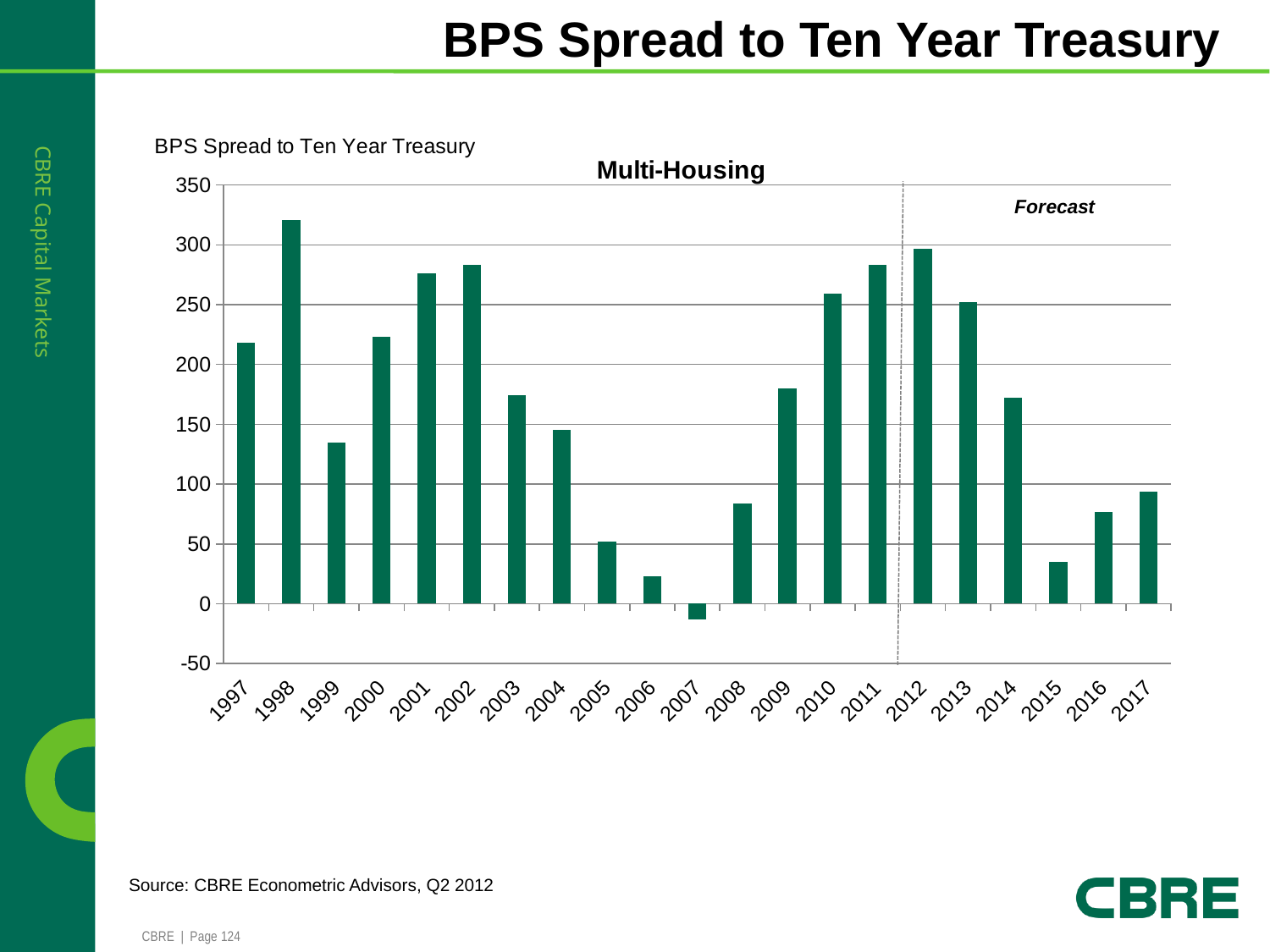
What label appears to the right of the dashed vertical line in the chart? Forecast Do the values rise or fall from 2004 to 2007? fall Which year has the lowest BPS spread in the Multi-Housing chart? 2007 Is the value for 1997 greater or less than 200? greater Which is larger, the value for 2009 or the value for 2010? 2010 What kind of chart is shown on the slide? bar chart Is the value for 2016 greater or less than 100? less Which is larger, the value for 1998 or the value for 2012? 1998 Is the value for 2012 greater or less than 250? greater Which year has the highest BPS spread in the Multi-Housing chart? 1998 How many years are plotted on the x axis of the chart? 21